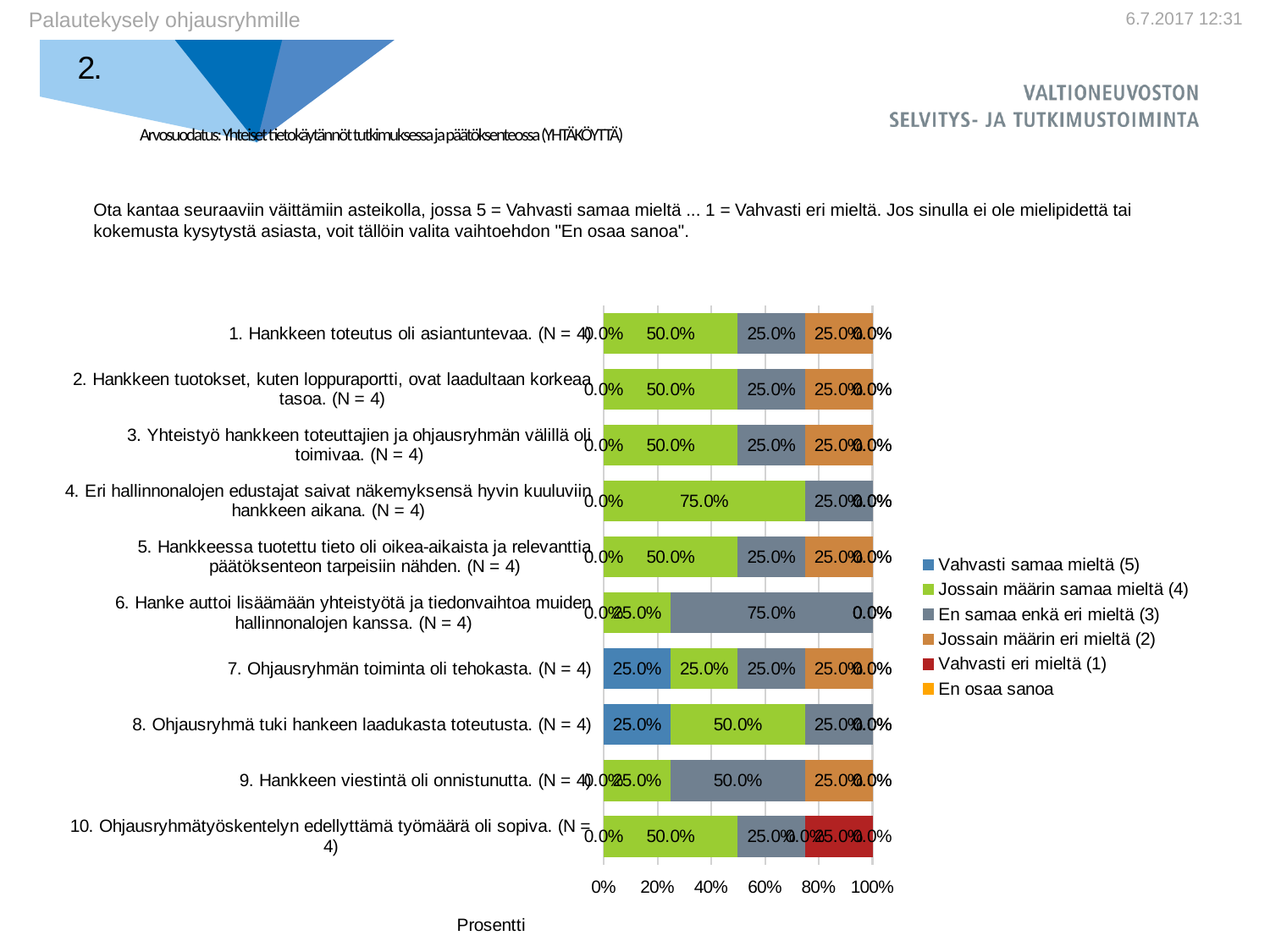
How many series does the chart legend list? 6 What is the 'Jossain määrin samaa mieltä (4)' share for statement 8 'Ohjausryhmä tuki hankeen laadukasta toteutusta'? 50.0% Which is larger for statement 1 'Hankkeen toteutus oli asiantuntevaa': the 'Jossain määrin samaa mieltä (4)' share or the 'En samaa enkä eri mieltä (3)' share? Jossain määrin samaa mieltä (4) What is the title of the horizontal axis of the chart? Prosentti What is the 'Vahvasti eri mieltä (1)' share for statement 10 'Ohjausryhmätyöskentelyn edellyttämä työmäärä oli sopiva'? 25.0% What is the 'Vahvasti samaa mieltä (5)' share for statement 7 'Ohjausryhmän toiminta oli tehokasta'? 25.0% What is the 'En samaa enkä eri mieltä (3)' share for statement 6 'Hanke auttoi lisäämään yhteistyötä ja tiedonvaihtoa muiden hallinnonalojen kanssa'? 75.0% What is the 'Jossain määrin samaa mieltä (4)' share for statement 4 'Eri hallinnonalojen edustajat saivat näkemyksensä hyvin kuuluviin hankkeen aikana'? 75.0% What kind of chart is shown on the slide? Stacked bar chart What is the difference between the 'En samaa enkä eri mieltä (3)' share for statement 6 and the 'Jossain määrin samaa mieltä (4)' share for statement 6? 50.0% What is the 'En samaa enkä eri mieltä (3)' share for statement 9 'Hankkeen viestintä oli onnistunutta'? 50.0% How many statements (categories) are plotted in the chart? 10